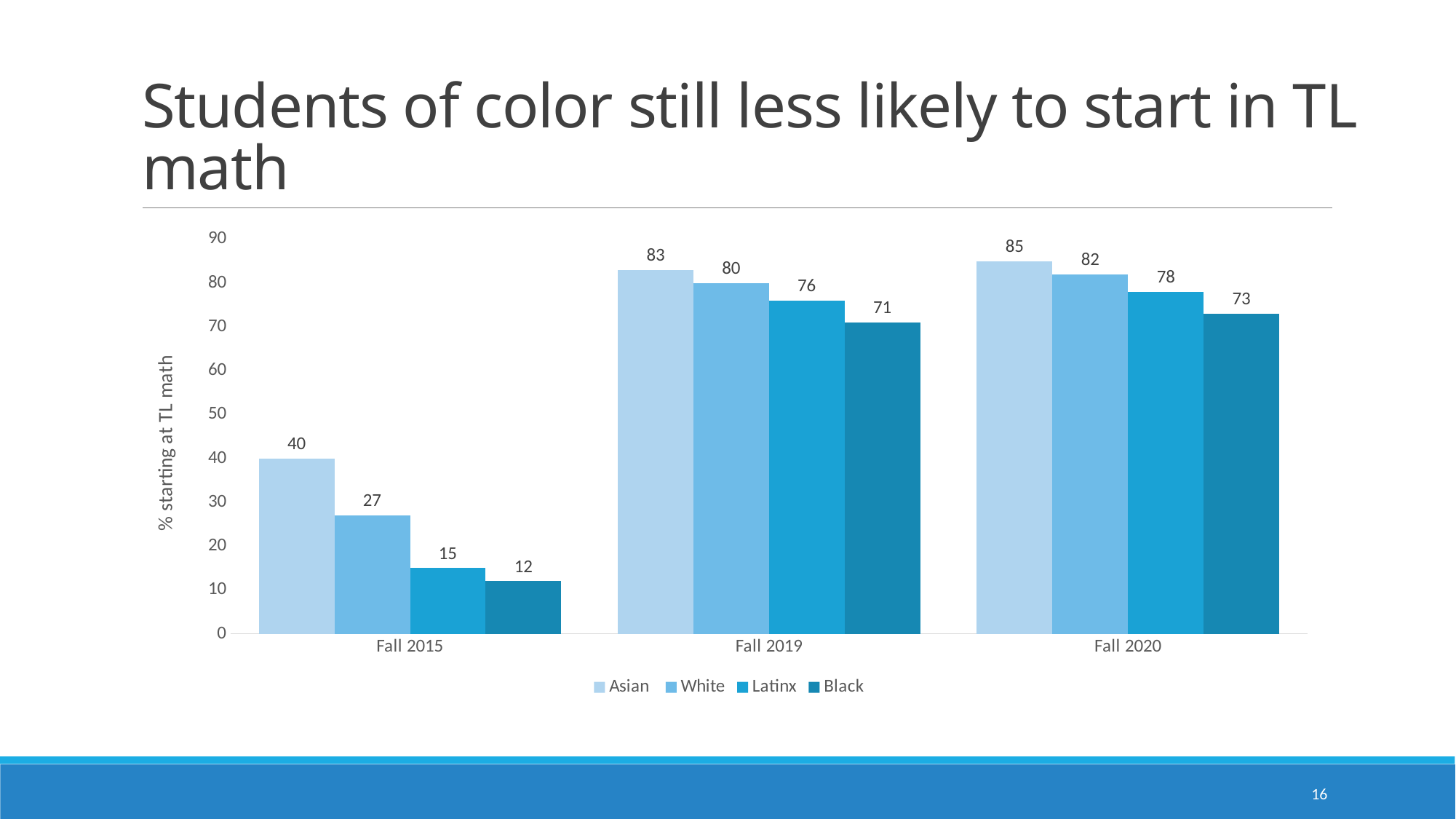
What is the difference between the Asian and Black values in Fall 2015? 28 How many series does the legend list? 4 What is the value for Latinx students in Fall 2020? 78 Which group has the highest value in Fall 2020? Asian What is the label of the y axis? % starting at TL math Which is larger: the Latinx value in Fall 2019 or the Black value in Fall 2020? Latinx value in Fall 2019 What is the difference between the White values in Fall 2020 and Fall 2019? 2 How many categories are shown on the x axis? 3 What is the value for Black students in Fall 2019? 71 Which group has the lowest value in Fall 2015? Black What is the value for Asian students in Fall 2015? 40 What kind of chart is shown on the slide? Bar chart